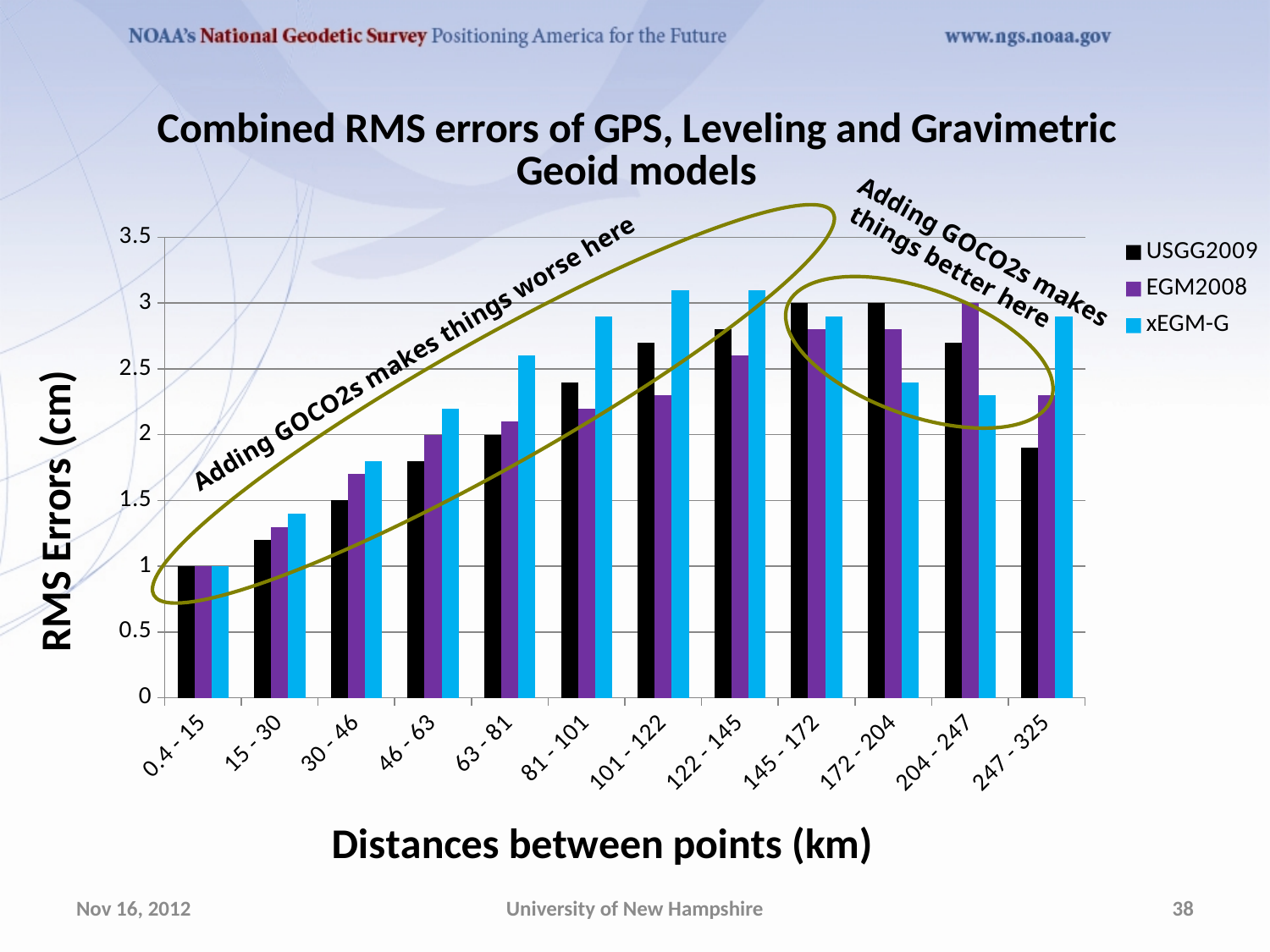
Do the xEGM-G values rise or fall from 0.4 - 15 km to 101 - 122 km? rise How many distance categories are shown on the x axis? 12 Is the EGM2008 value for 247 - 325 km greater or less than 2.5? less What is the RMS error for USGG2009 in the 145 - 172 km category? 3 In the 204 - 247 km category, which is larger: EGM2008 or xEGM-G? EGM2008 In the 81 - 101 km category, which is larger: USGG2009 or xEGM-G? xEGM-G Which distance category has the lowest xEGM-G value? 0.4 - 15 What kind of chart is shown on the slide? bar chart Is the xEGM-G value for 81 - 101 km greater or less than 2.5? greater What is the RMS error for USGG2009 in the 0.4 - 15 km category? 1 How many series does the legend list? 3 Which series has the highest value in the 172 - 204 km category? USGG2009